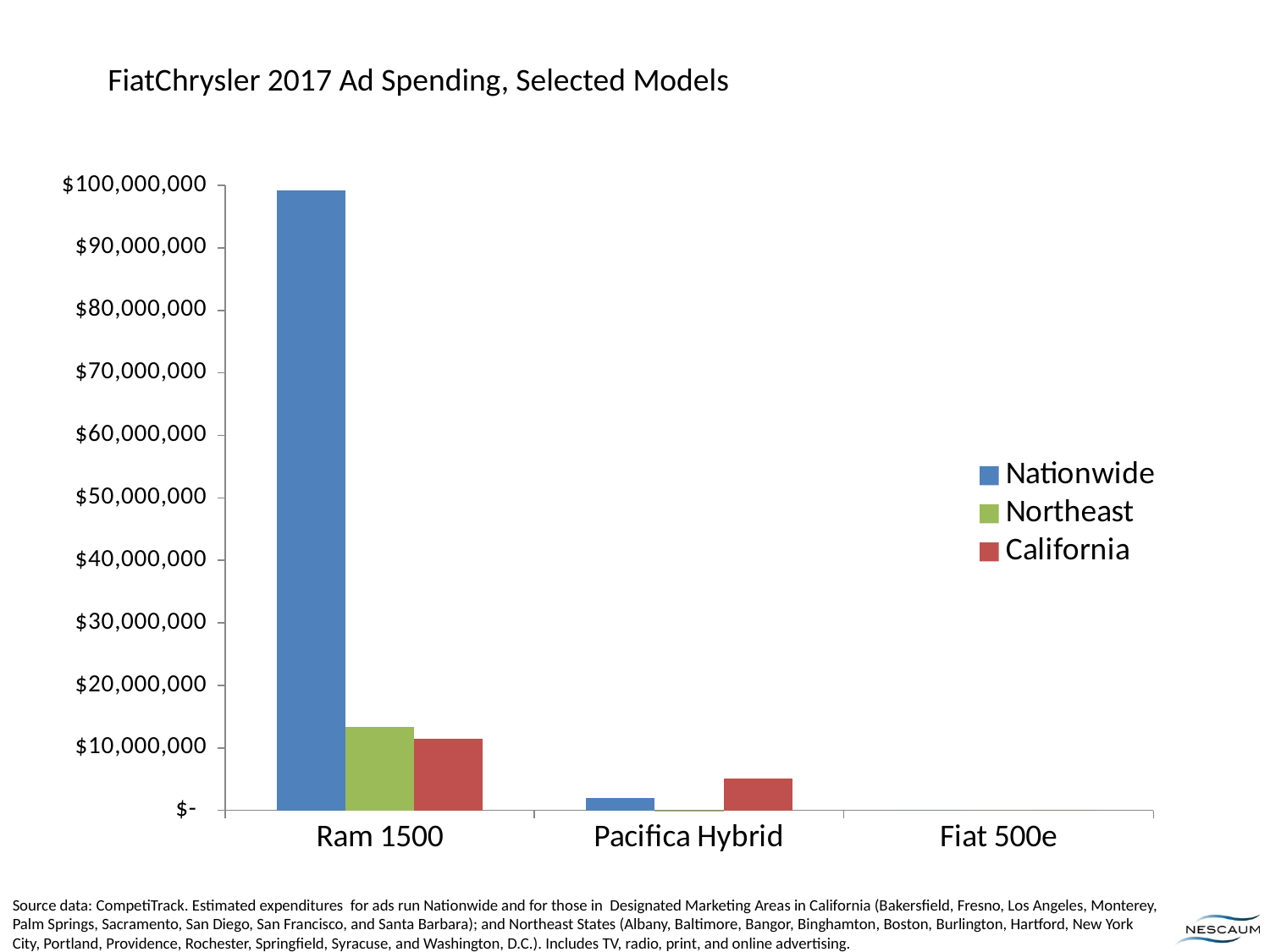
Which model has the highest Nationwide ad spending? Ram 1500 How many vehicle models are shown on the x axis? 3 How many series does the legend list? 3 Is the California ad spending for Pacifica Hybrid greater or less than $10,000,000? less For Pacifica Hybrid, which is larger: Nationwide or California ad spending? California Which series is shown in red in the legend? California What kind of chart is shown on the slide? bar chart Is the Northeast ad spending for Ram 1500 greater or less than $20,000,000? less For Ram 1500, which is larger: Northeast or California ad spending? Northeast What is the title of the chart? FiatChrysler 2017 Ad Spending, Selected Models Is the Nationwide ad spending for Ram 1500 greater or less than $90,000,000? greater